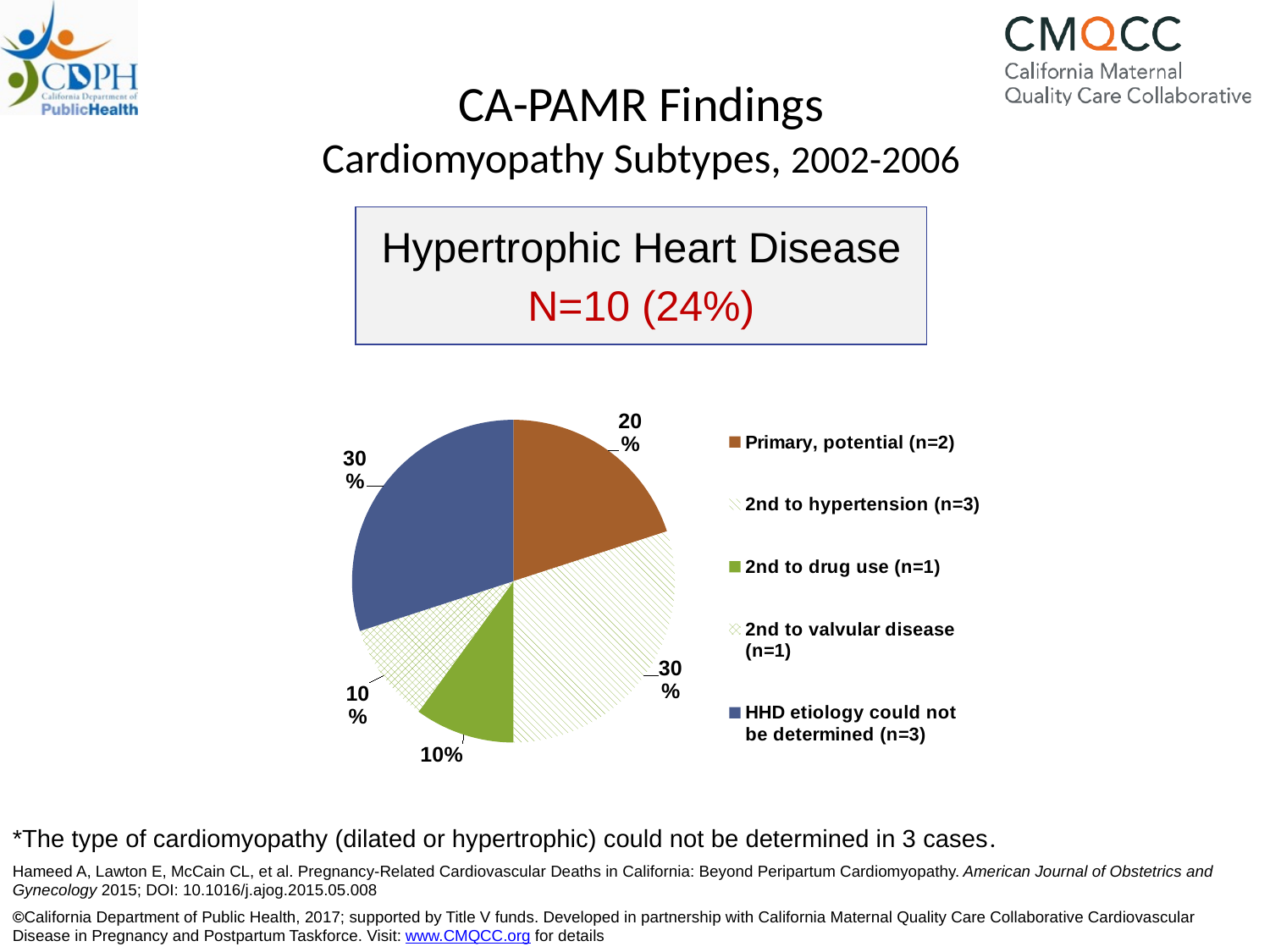
What percentage of the pie is the "2nd to hypertension (n=3)" slice? 30% What percentage of the pie is the "Primary, potential (n=2)" slice? 20% How many cases (n) are in the "2nd to hypertension" legend entry? 3 Which is larger: the "Primary, potential (n=2)" slice or the "2nd to drug use (n=1)" slice? Primary, potential (n=2) What is the difference in percentage points between the "2nd to hypertension (n=3)" slice and the "2nd to valvular disease (n=1)" slice? 20 percentage points What is the subtitle of the slide below "CA-PAMR Findings"? Cardiomyopathy Subtypes, 2002-2006 How many slices does the pie chart have? 5 How many entries does the legend list? 5 What type of chart is shown on the slide? pie chart What percentage of the pie is the "2nd to drug use (n=1)" slice? 10% What is the total number of cases (N) shown in the box above the pie chart? 10 What percentage of the pie is the "HHD etiology could not be determined (n=3)" slice? 30%